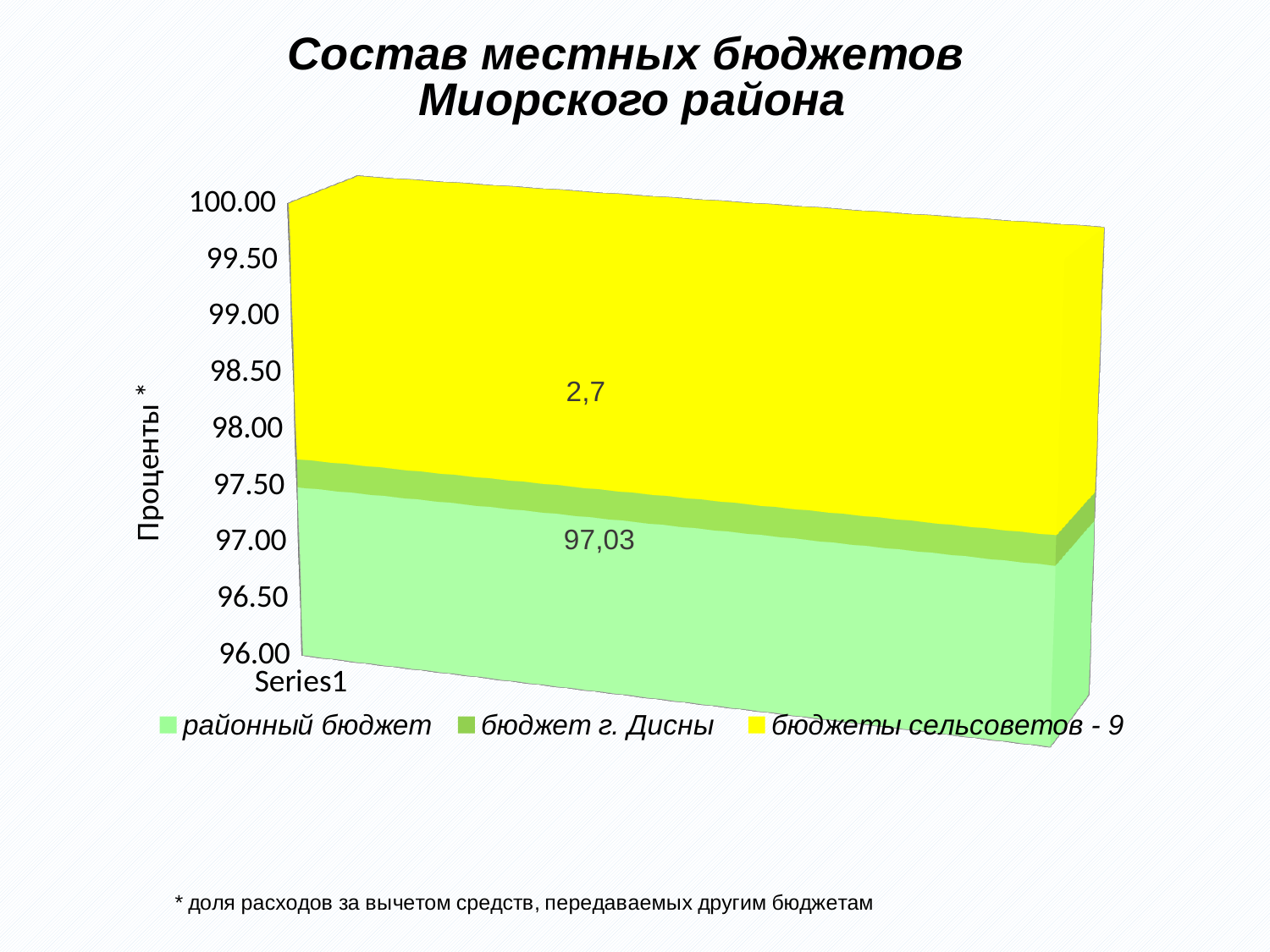
What is the label of the vertical axis? Проценты * What is the title of the chart? Состав местных бюджетов Миорского района What is the difference between the value for районный бюджет and the value for бюджеты сельсоветов - 9? 94,33 How many series does the legend list? 3 What value is shown for районный бюджет? 97,03 What value is shown for бюджеты сельсоветов - 9? 2,7 Which series has the smallest value in the bar? бюджет г. Дисны Which is larger, the value for районный бюджет or the value for бюджеты сельсоветов - 9? районный бюджет What kind of chart is shown on the slide? Stacked area chart Which series has the largest value in the bar? районный бюджет